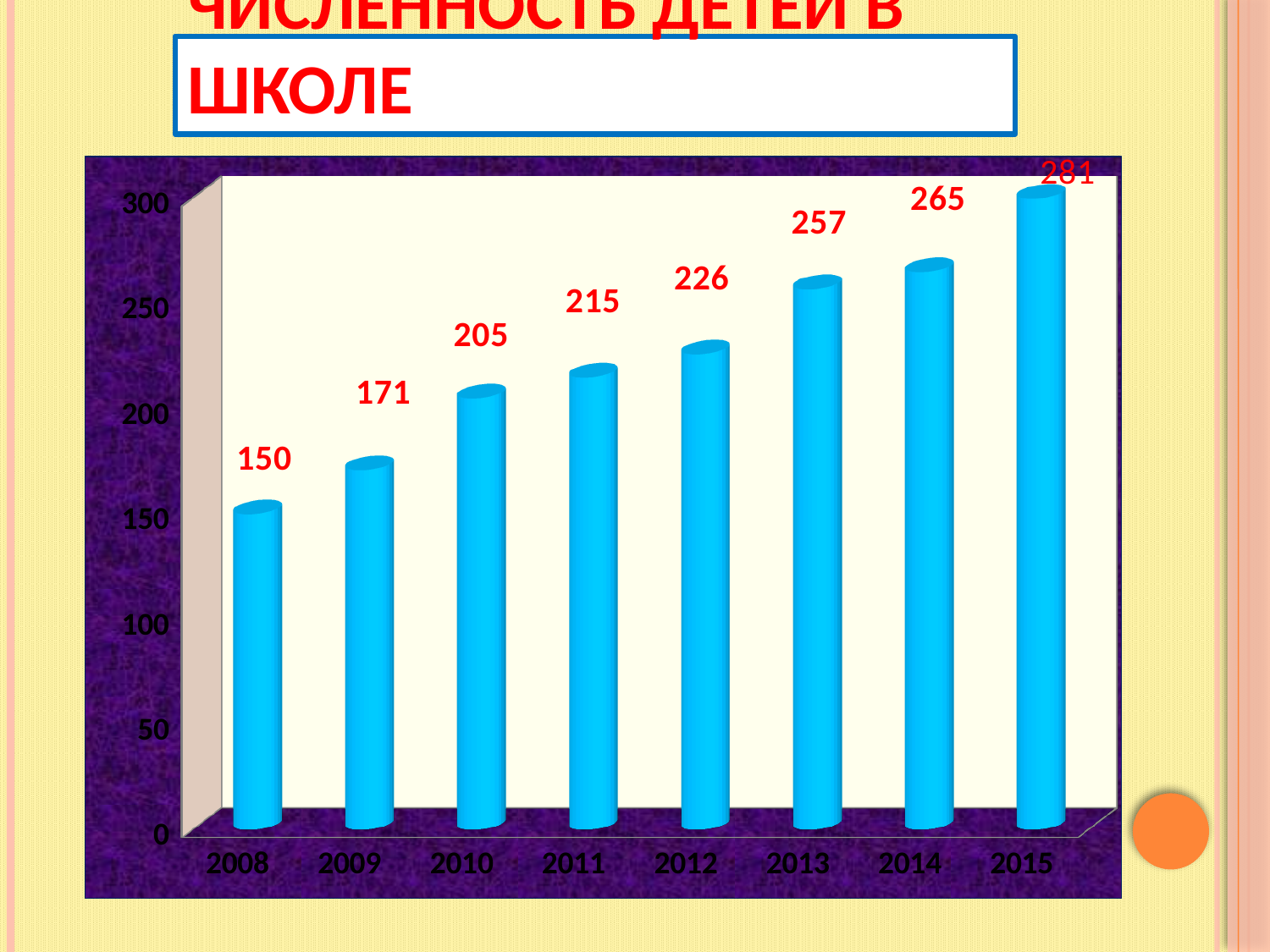
Which year has the lowest value? 2008 How many years are shown on the x axis? 8 What kind of chart is shown on the slide? bar chart What is the value for 2014? 265 What is the value for 2012? 226 Which year has the highest value? 2015 Do the values rise or fall from 2008 to 2015? rise Which is larger, the value for 2010 or the value for 2011? 2011 What is the difference between the values for 2013 and 2012? 31 Is the value for 2009 greater or less than 200? less What is the difference between the values for 2015 and 2008? 131 What is the value for 2008? 150